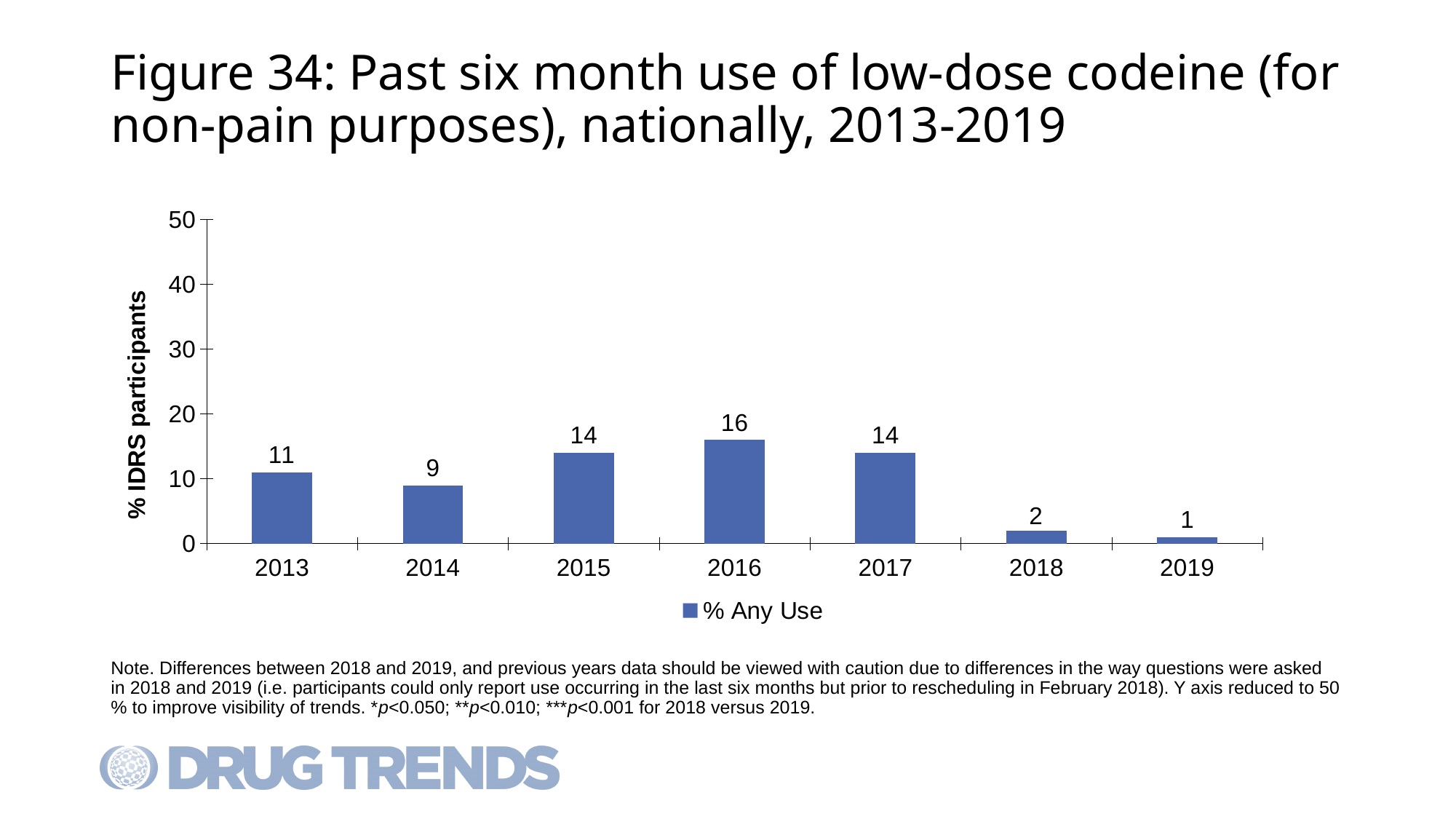
Which year has the highest value? 2016 What is the value for 2016? 16 How many series does the legend list? 1 How many years are shown on the x axis? 7 Is the value for 2017 greater or less than 10? greater What is the value for 2019? 1 What is the label of the y axis? % IDRS participants Which year has the lowest value? 2019 Which is larger, the value for 2013 or the value for 2014? 2013 What is the difference between the values for 2016 and 2018? 14 What kind of chart is shown? bar chart What is the value for 2014? 9